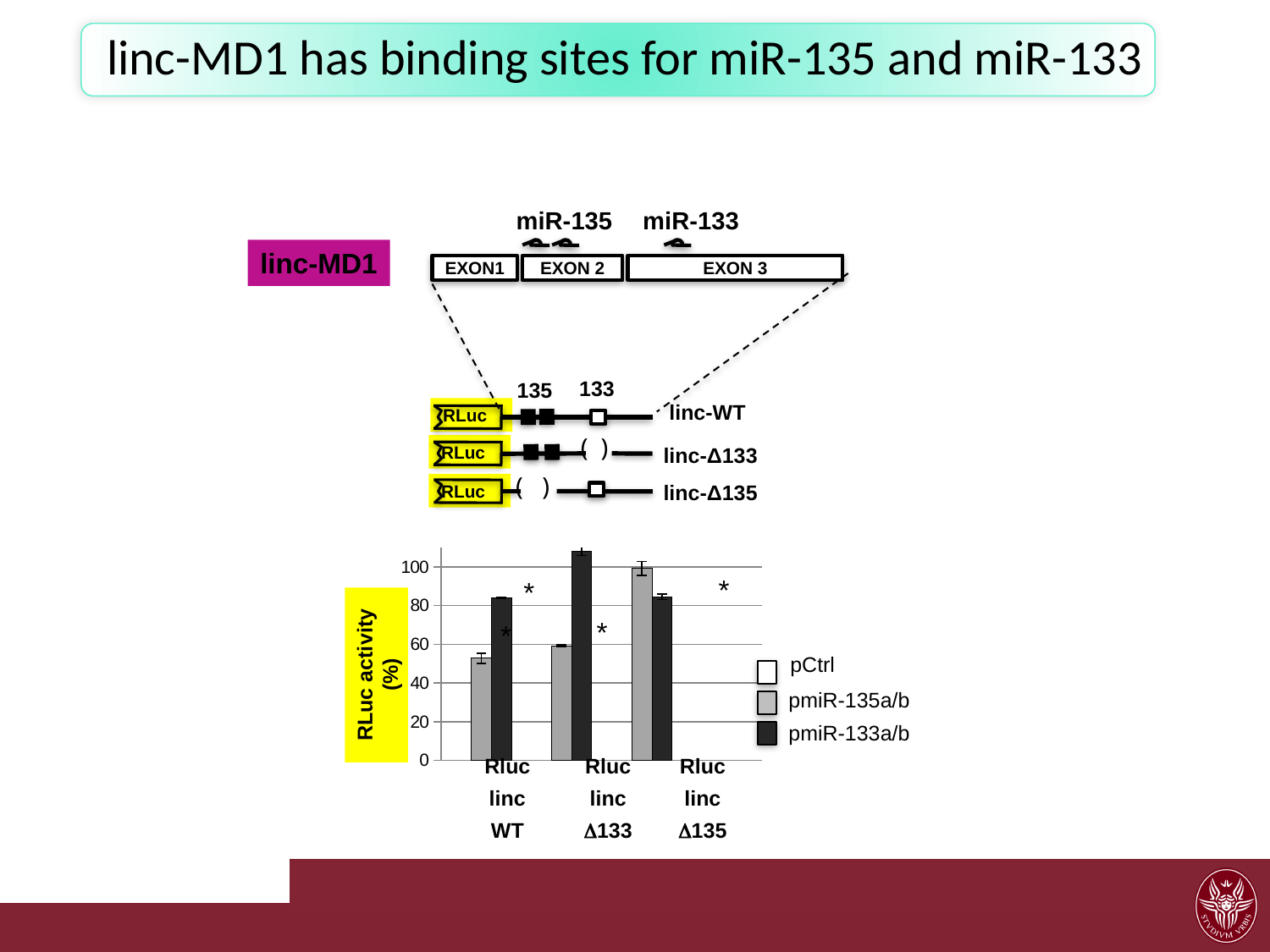
For Rluc linc WT, which is larger: the pmiR-135a/b bar or the pmiR-133a/b bar? pmiR-133a/b For Rluc linc Δ135, which is larger: the pmiR-135a/b bar or the pmiR-133a/b bar? pmiR-135a/b What kind of chart is shown on the slide? bar chart Which series is shown in black in the bar chart legend? pmiR-133a/b How many categories are shown on the x axis of the bar chart? 3 Is the pmiR-133a/b value for Rluc linc Δ133 greater or less than 100? greater Is the pmiR-135a/b value for Rluc linc Δ135 greater or less than 80? greater Is the pmiR-135a/b value for Rluc linc WT greater or less than 60? less How many series does the legend of the bar chart list? 3 What is the label of the y axis of the bar chart? RLuc activity (%) Which category has the highest pmiR-133a/b value? Rluc linc Δ133